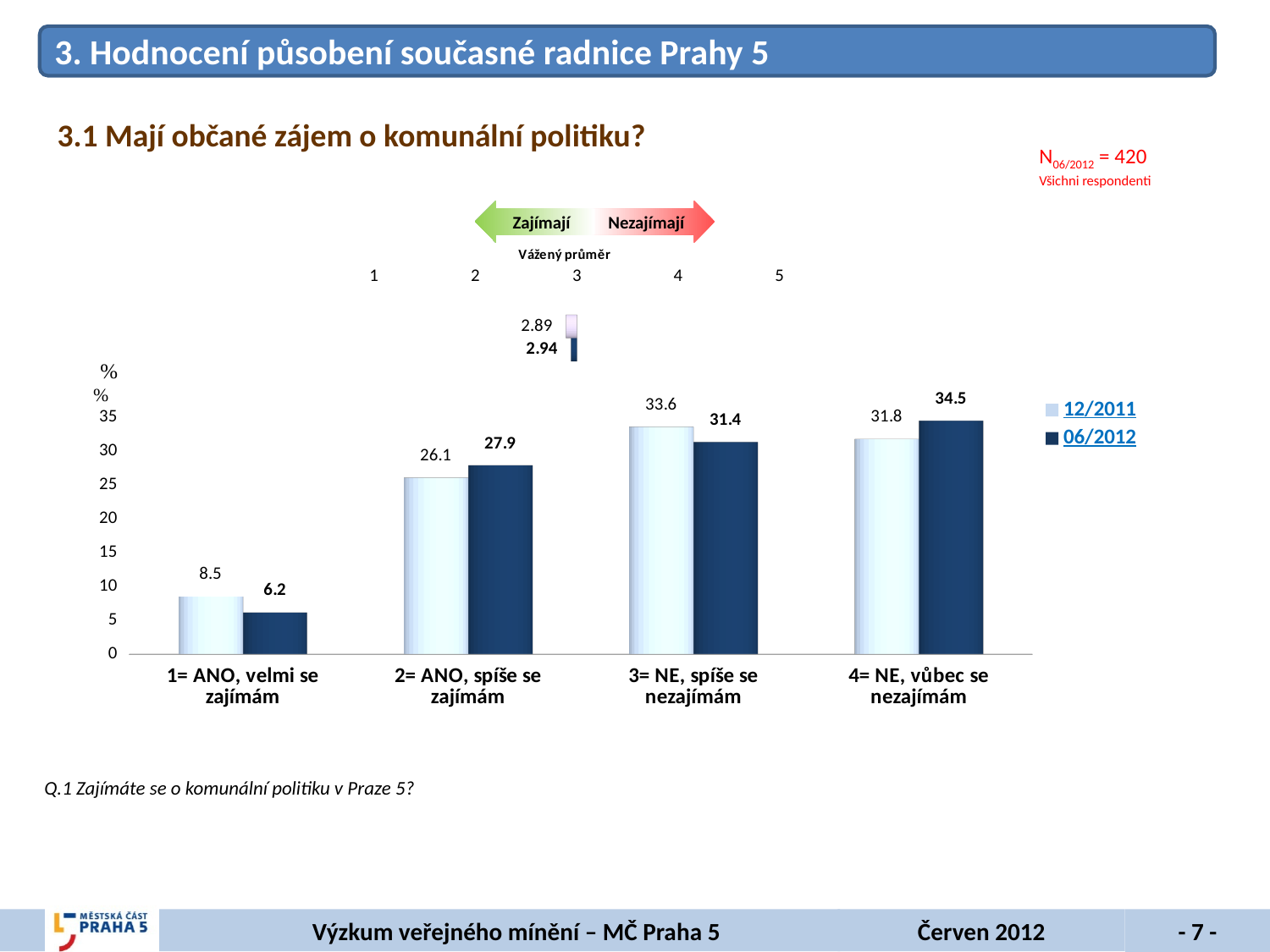
In the main bar chart, which category has the highest 06/2012 value? 4= NE, vůbec se nezajímám How many categories are shown on the x axis of the main bar chart? 4 How many series does the legend of the main bar chart list? 2 In the main bar chart, what is the 06/2012 value for "2= ANO, spíše se zajímám"? 27.9 In the "Vážený průměr" chart, what is the weighted average for 06/2012? 2.94 In the main bar chart, what is the difference between the 12/2011 and 06/2012 values for "3= NE, spíše se nezajímám"? 2.2 In the "Vážený průměr" chart, what is the difference between the 06/2012 and 12/2011 weighted averages? 0.05 In the main bar chart, what is the 12/2011 value for "3= NE, spíše se nezajímám"? 33.6 In the main bar chart, for "4= NE, vůbec se nezajímám", which series has the larger value, 12/2011 or 06/2012? 06/2012 What kind of chart is the main chart on the slide? bar chart In the main bar chart, what is the 12/2011 value for "1= ANO, velmi se zajímám"? 8.5 In the main bar chart, which category has the lowest 12/2011 value? 1= ANO, velmi se zajímám